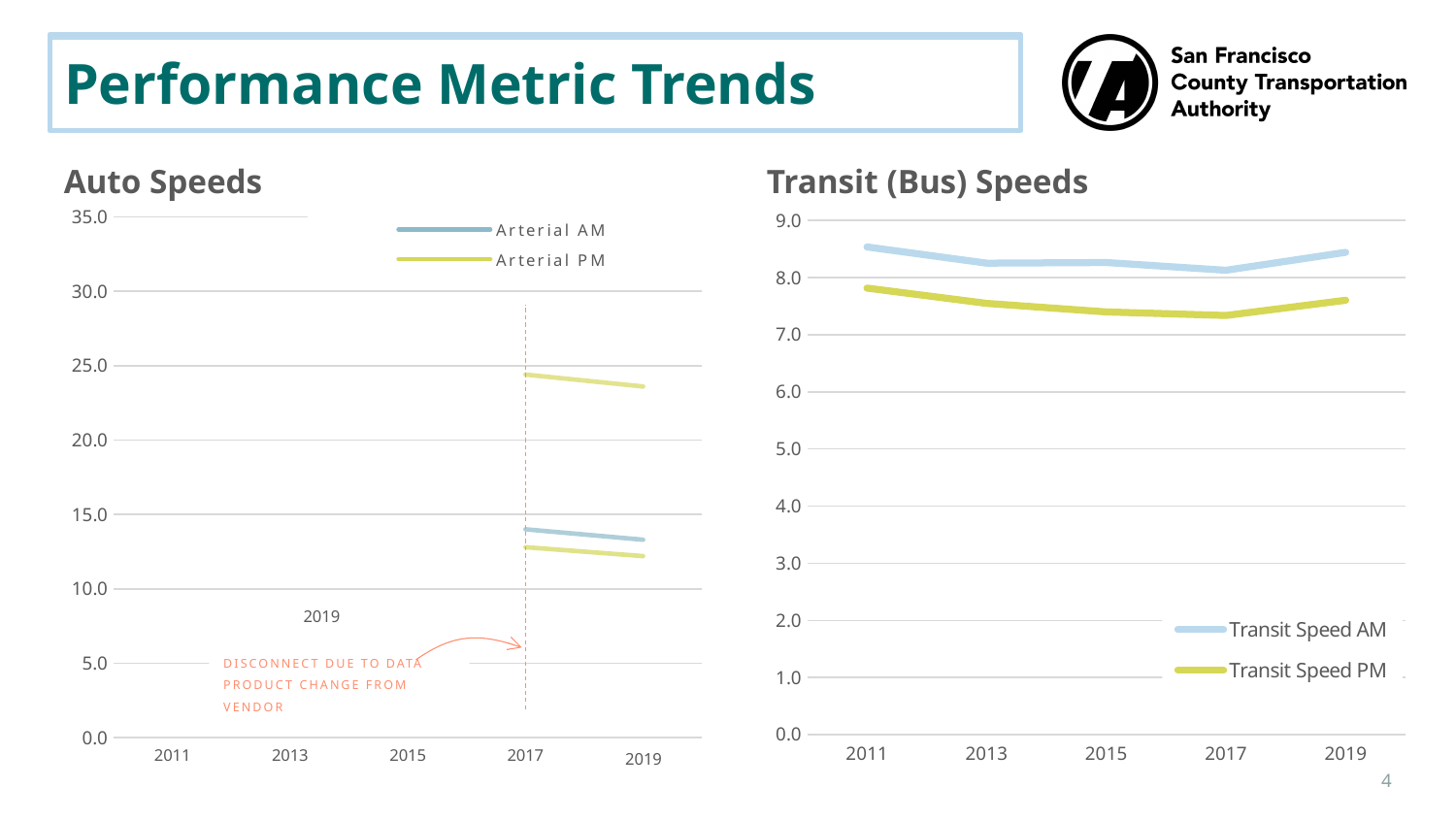
In the Transit (Bus) Speeds chart, which series has the higher value in 2019, Transit Speed AM or Transit Speed PM? Transit Speed AM In the Transit (Bus) Speeds chart, is the Transit Speed PM value for 2011 greater or less than 7.0? greater How many series does the legend of the Transit (Bus) Speeds chart list? 2 How many series does the legend of the Auto Speeds chart list? 2 In the Transit (Bus) Speeds chart, is the Transit Speed PM value for 2017 greater or less than 8.0? less In the Transit (Bus) Speeds chart, does the Transit Speed PM line rise or fall from 2011 to 2017? fall What are the two legend entries in the Transit (Bus) Speeds chart? Transit Speed AM and Transit Speed PM In the Transit (Bus) Speeds chart, how many years are labelled on the x axis? 5 What type of chart is the Transit (Bus) Speeds chart? line chart In the Transit (Bus) Speeds chart, is the Transit Speed AM value for 2011 greater or less than 8.0? greater What does the annotation in the Auto Speeds chart say is the reason for the disconnect in the data? Data product change from vendor